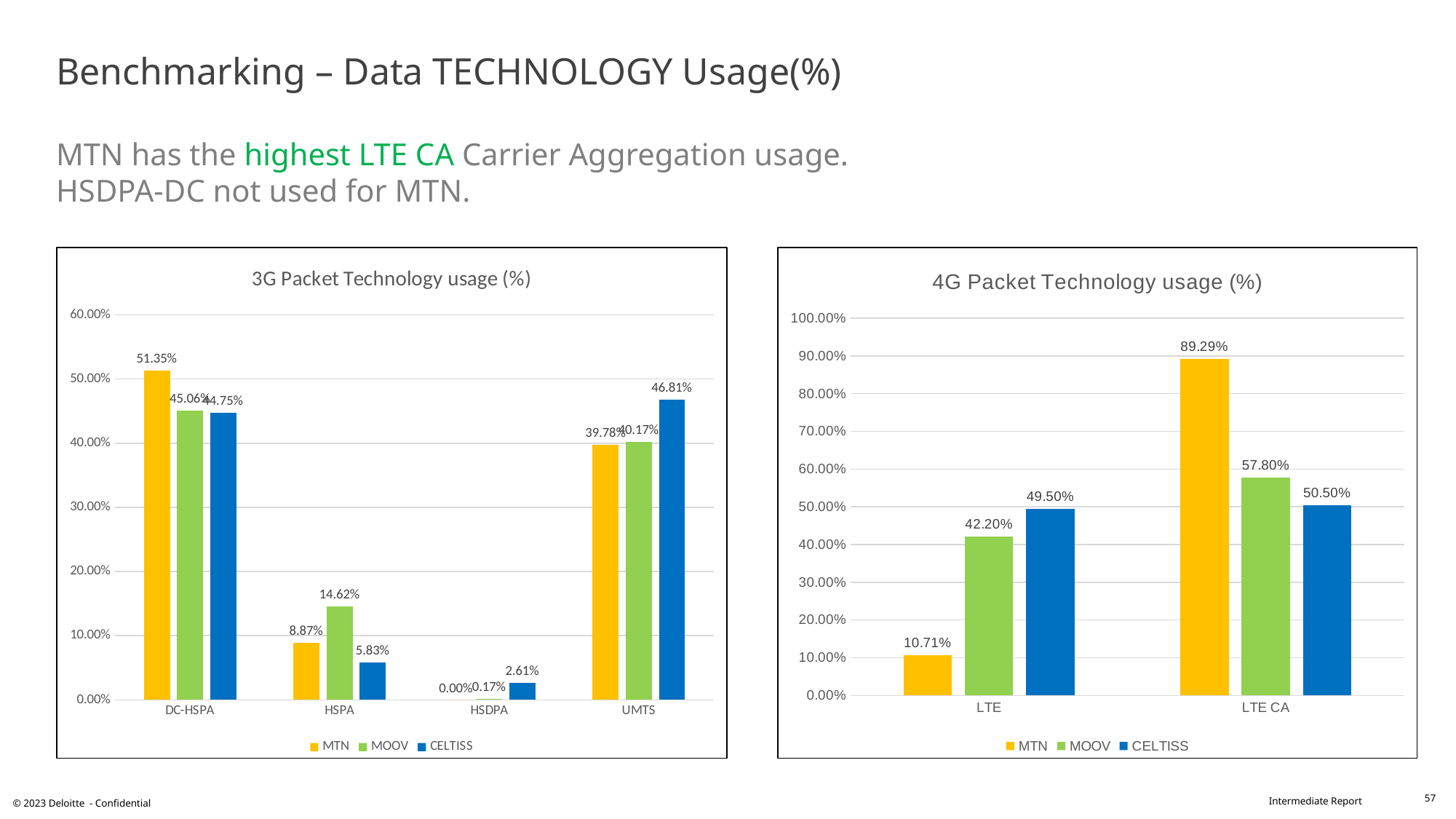
How many categories are shown on the x axis of the 3G Packet Technology usage (%) chart? 4 What kind of chart is the 4G Packet Technology usage (%) chart? Bar chart In the 3G Packet Technology usage (%) chart, what is the value for MOOV in the HSPA category? 14.62% In the 4G Packet Technology usage (%) chart, what is the value for MTN in the LTE CA category? 89.29% In the 4G Packet Technology usage (%) chart, which operator has the highest value in the LTE category? CELTISS In the 3G Packet Technology usage (%) chart, is the MTN value for DC-HSPA greater or less than 50.00%? greater In the 3G Packet Technology usage (%) chart, which operator has the lowest value in the HSDPA category? MTN How many series does the legend of the 4G Packet Technology usage (%) chart list? 3 In the 3G Packet Technology usage (%) chart, what is the difference between the MTN and CELTISS values for DC-HSPA? 6.60% In the 4G Packet Technology usage (%) chart, what is the difference between the MTN and MOOV values for LTE CA? 31.49% In the 4G Packet Technology usage (%) chart, which is larger for LTE: the MOOV value or the CELTISS value? CELTISS In the 3G Packet Technology usage (%) chart, what is the value for CELTISS in the UMTS category? 46.81%